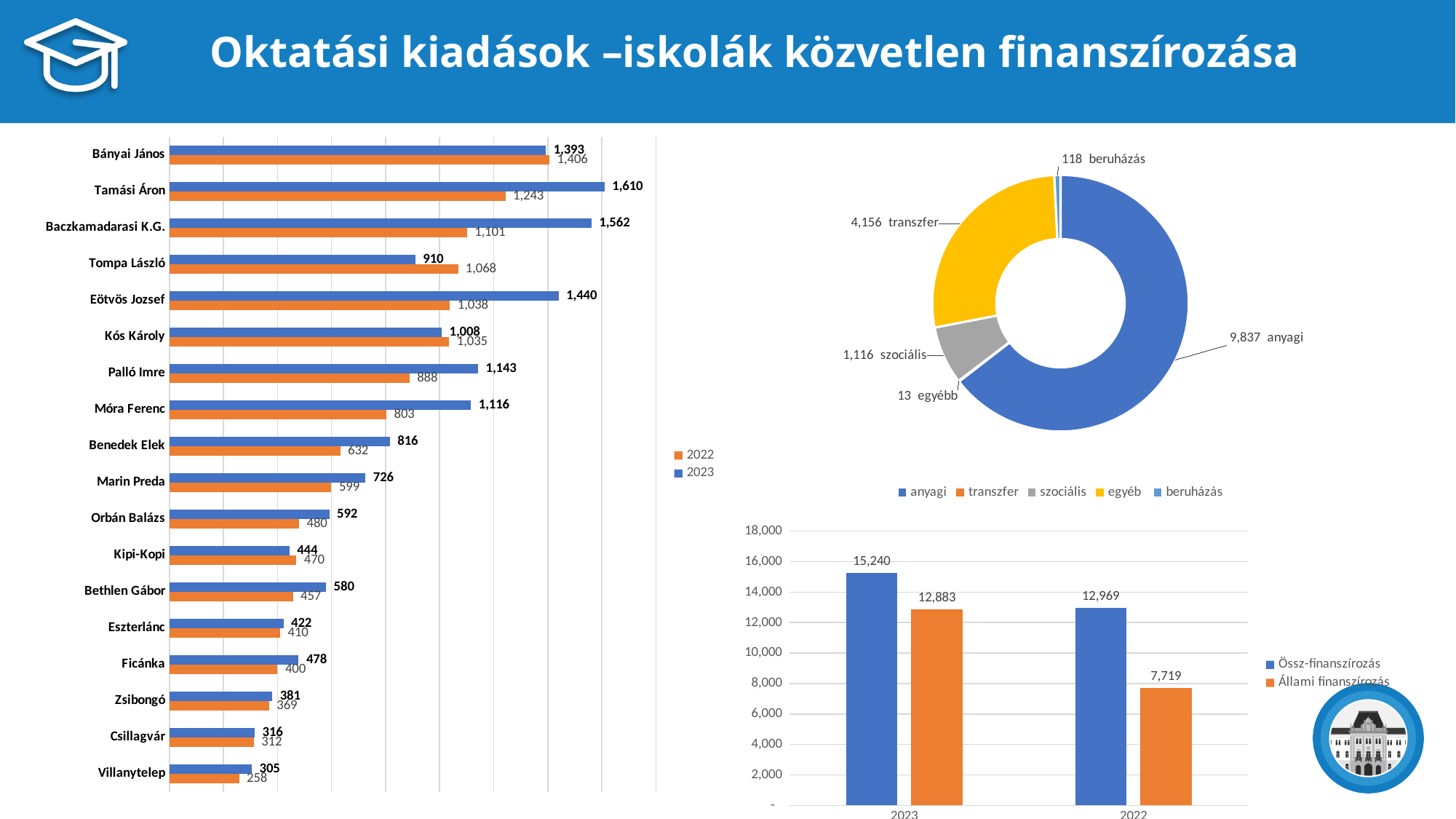
In the doughnut chart at the top right, which category has the smallest value? egyéb In the doughnut chart at the top right, what is the value for transzfer? 4,156 In the bottom-right bar chart, what is the difference between Össz-finanszírozás and Állami finanszírozás in 2022? 5,250 In the left bar chart, what is the 2023 value for Tamási Áron? 1,610 In the left bar chart, which school has the lowest 2022 value? Villanytelep How many series does the legend of the left bar chart list? 2 In the left bar chart, what is the 2022 value for Eötvös Jozsef? 1,038 In the left bar chart, what is the difference between the 2023 and 2022 values for Tamási Áron? 367 In the left bar chart, is the 2022 value for Bányai János larger or smaller than its 2023 value? larger How many schools are listed in the left bar chart? 18 In the left bar chart, which school has the highest 2023 value? Tamási Áron In the bottom-right bar chart, what is the Állami finanszírozás value for 2022? 7,719